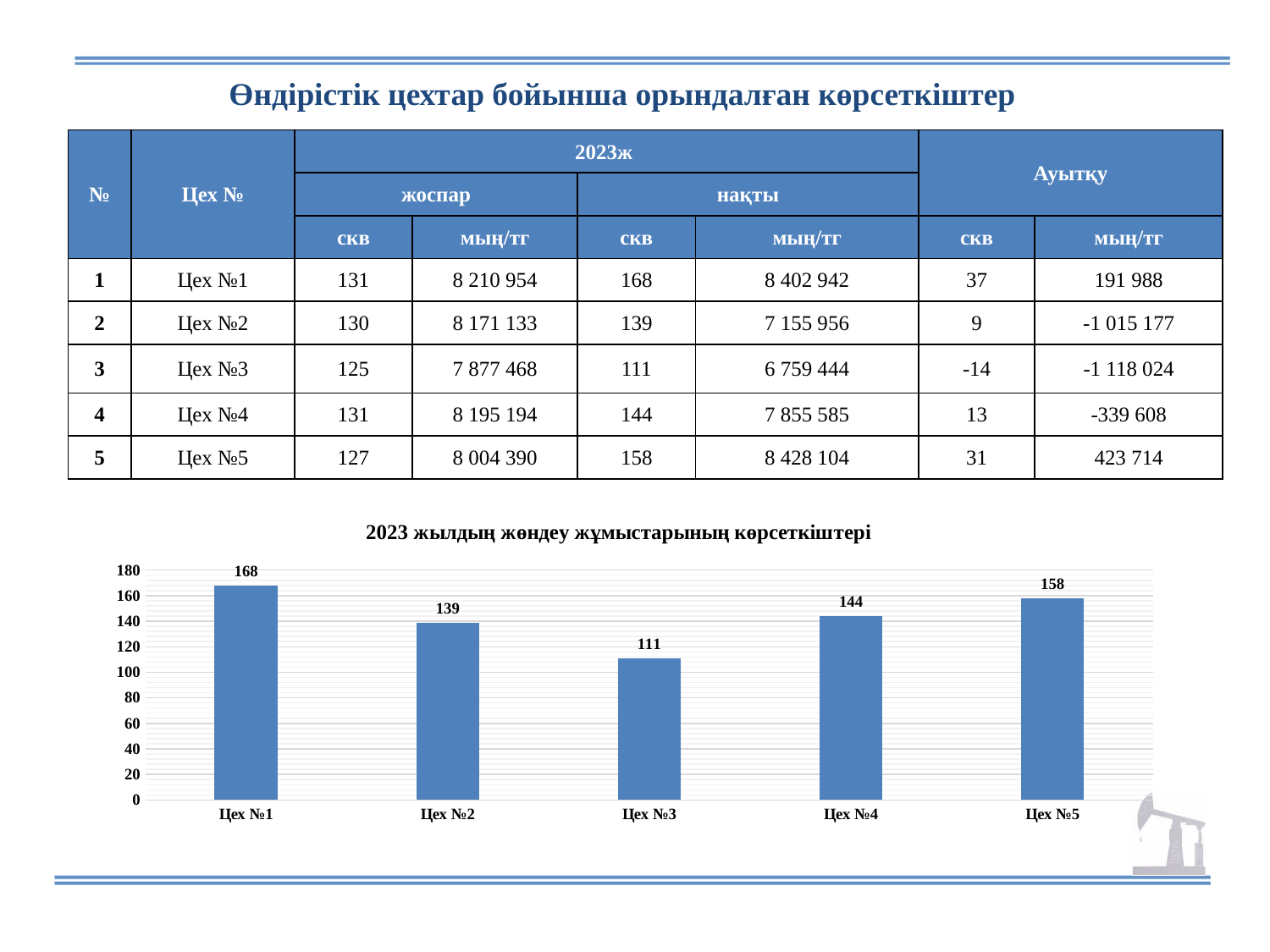
How many categories are shown in the chart? 5 What kind of chart is shown on the slide? bar chart What is the title of the chart? 2023 жылдың жөндеу жұмыстарының көрсеткіштері Which is larger, the value for Цех №2 or the value for Цех №5? Цех №5 Which category has the highest value in the chart? Цех №1 Is the value for Цех №4 greater or less than 120? greater What is the value for Цех №5 in the chart? 158 What is the value for Цех №3 in the chart? 111 What is the difference between the values for Цех №1 and Цех №3? 57 What is the difference between the values for Цех №4 and Цех №2? 5 What is the value for Цех №1 in the chart? 168 Which category has the lowest value in the chart? Цех №3